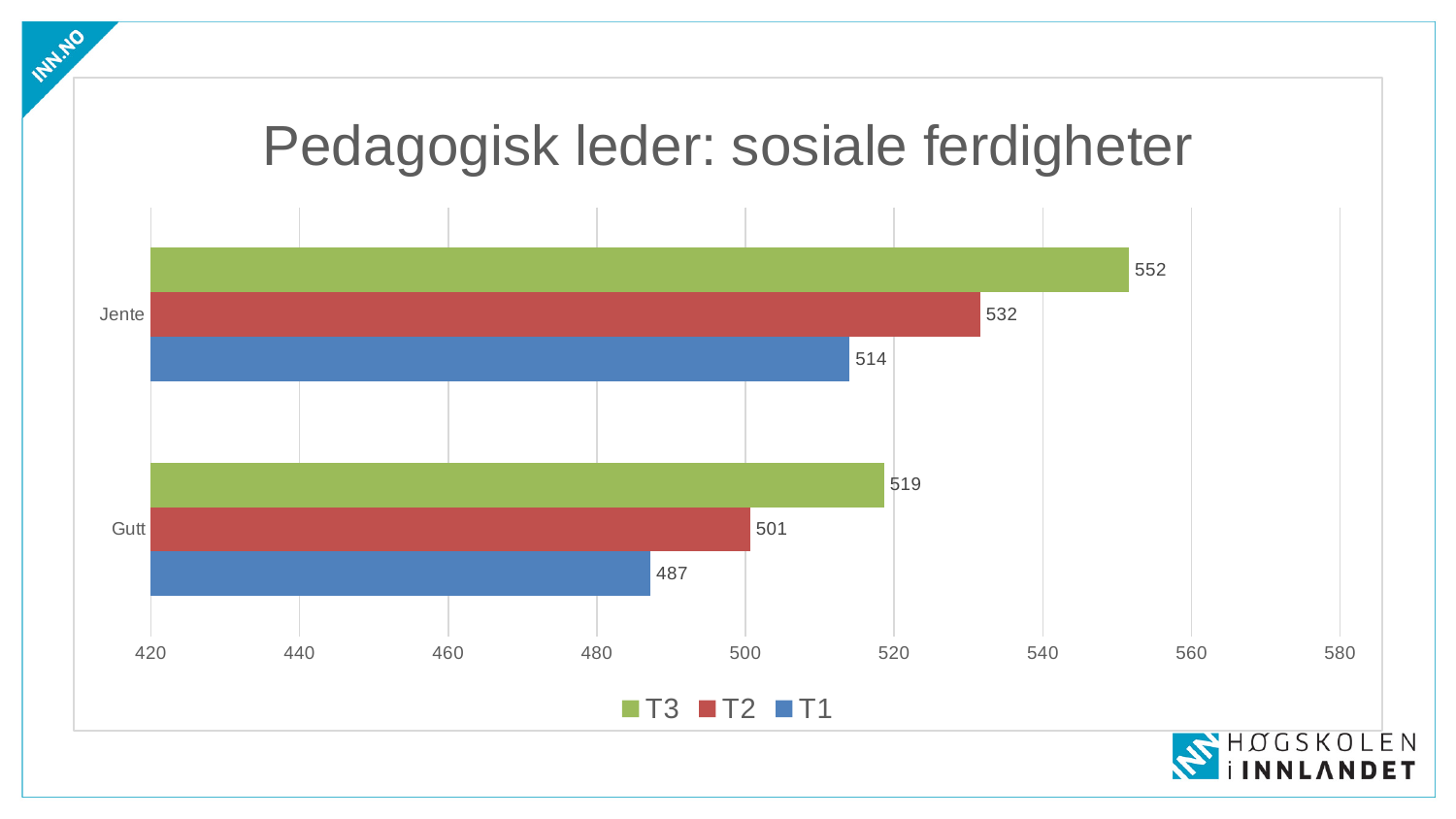
How many categories are shown on the chart? 2 What kind of chart is shown on the slide? Bar chart What is the T1 value for Gutt? 487 Which is larger, the T3 value for Gutt or the T1 value for Jente? T3 value for Gutt Which series has the lowest value for Gutt? T1 What is the difference between the T3 and T1 values for Jente? 38 What is the T3 value for Jente? 552 Which category has the highest T3 value? Jente Is the T2 value for Gutt greater or less than 500? greater What is the difference between the T2 values for Jente and Gutt? 31 How many series does the legend list? 3 What is the T2 value for Jente? 532